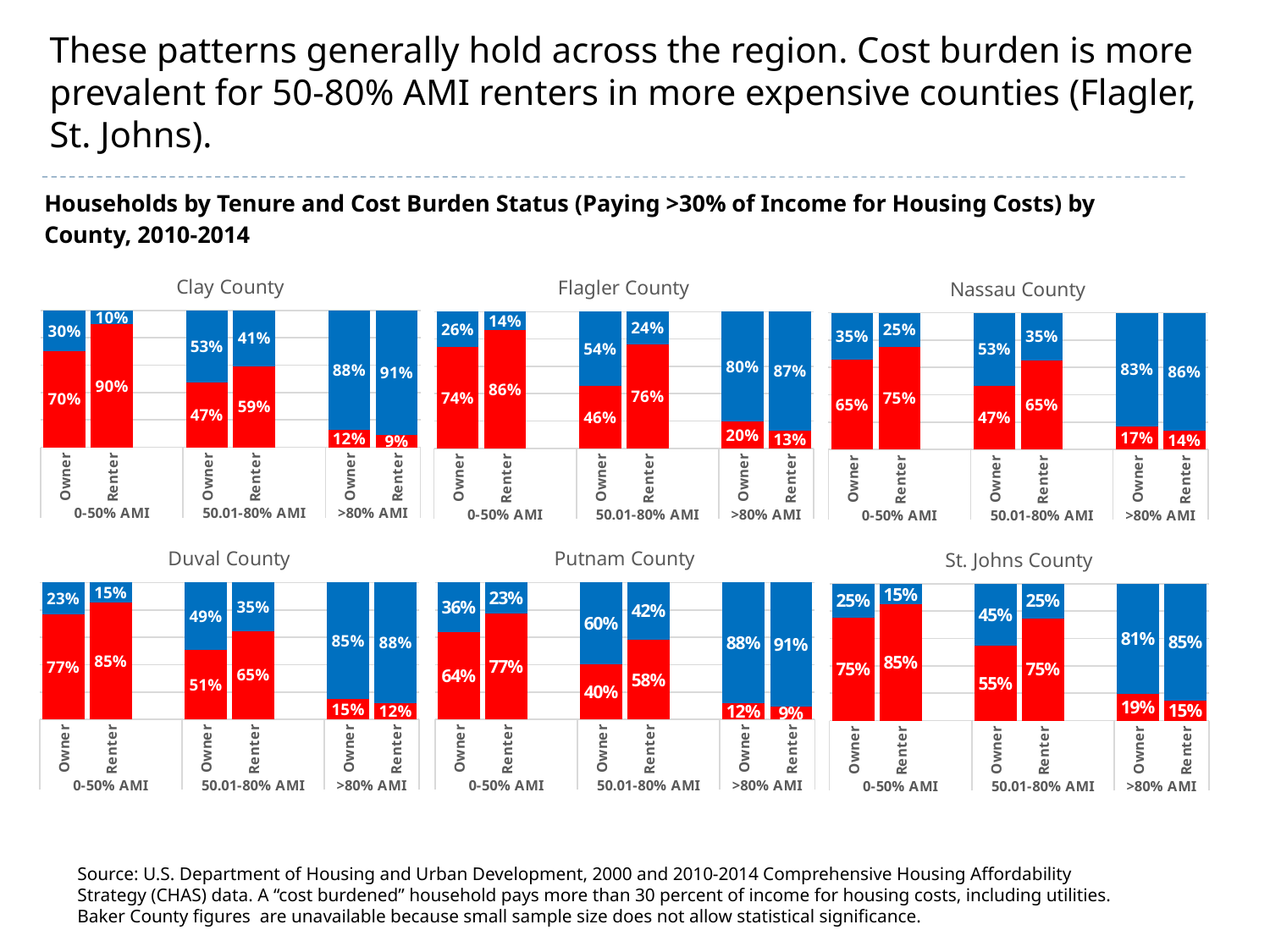
In the Flagler County chart, what is the value of the red segment for Renter households at 50.01-80% AMI? 76% In the Putnam County chart, which bar has the smallest red segment? Renter, >80% AMI In the St. Johns County chart, what is the value of the blue segment for Owner households at >80% AMI? 81% In the Duval County chart, which bar has the largest red segment? Renter, 0-50% AMI In the Flagler County chart, is the red segment larger for Owner or Renter households at 0-50% AMI? Renter How many bars are plotted in the Duval County chart? 6 In the St. Johns County chart, what is the difference between the red segments for Renter and Owner households at 50.01-80% AMI? 20 percentage points In the Nassau County chart, what is the value of the red segment for Owner households at 50.01-80% AMI? 47% In the Clay County chart, what is the total of the two segments in the Owner bar at >80% AMI? 100% What type of chart is used for each county on this slide? Stacked bar chart How many county charts are shown on the slide? 6 In the Clay County chart, what is the value of the red segment for Renter households at 0-50% AMI? 90%